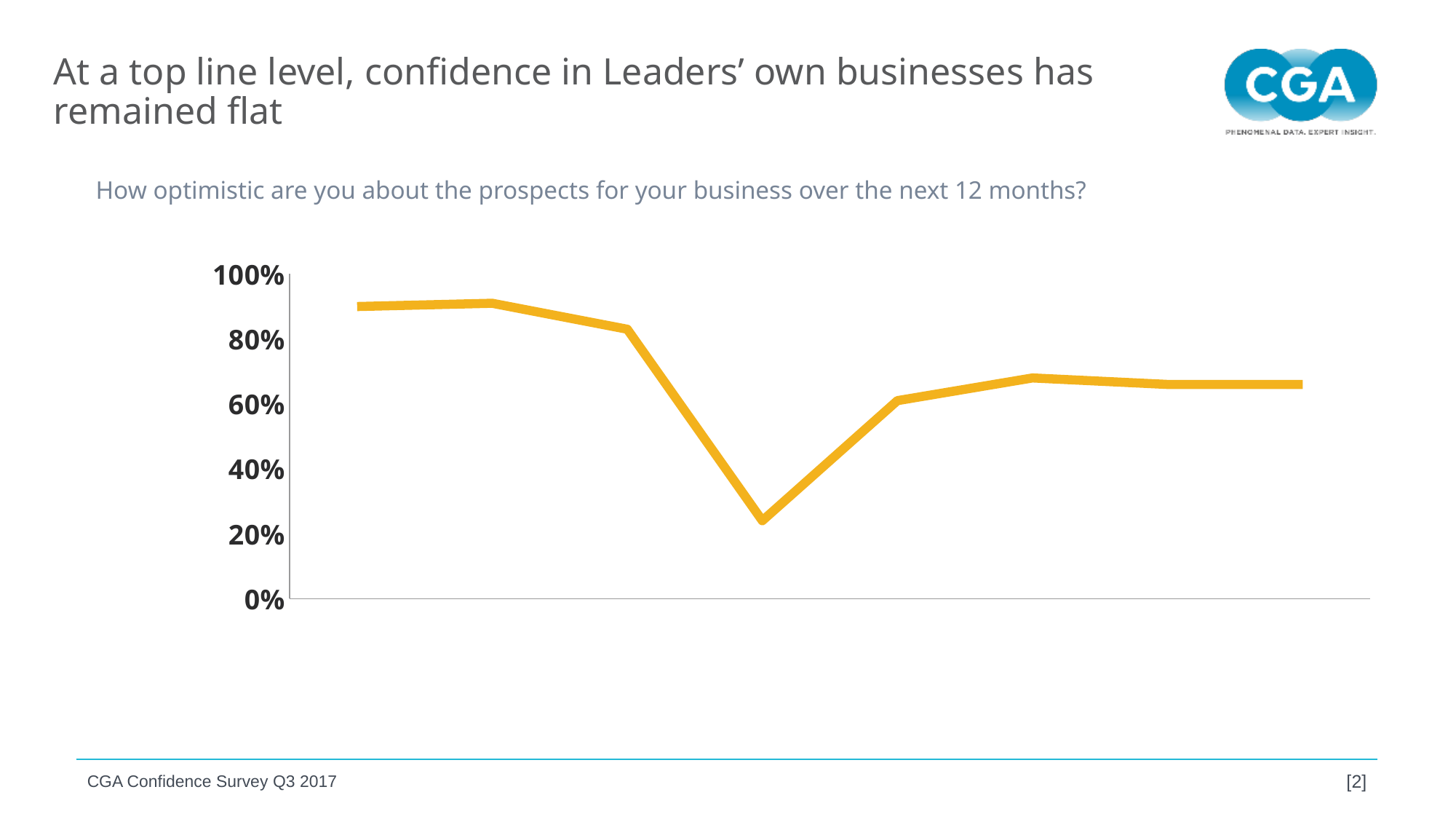
How many lines (series) are plotted on the chart? 1 How many data points are plotted on the line? 8 Is the value of the first (leftmost) point on the line greater or less than 80%? greater Is the value of the last (rightmost) point on the line greater or less than 80%? less Does the line rise or fall between the fourth and fifth points from the left? rise What is the highest value shown on the vertical axis? 100% What colour is the plotted line? yellow/orange Which point on the line is the lowest? the fourth point from the left Is the value of the last (rightmost) point on the line greater or less than 60%? greater Comparing the first point to the last point, is the line overall higher or lower at the end? lower What kind of chart is shown on the slide? line chart